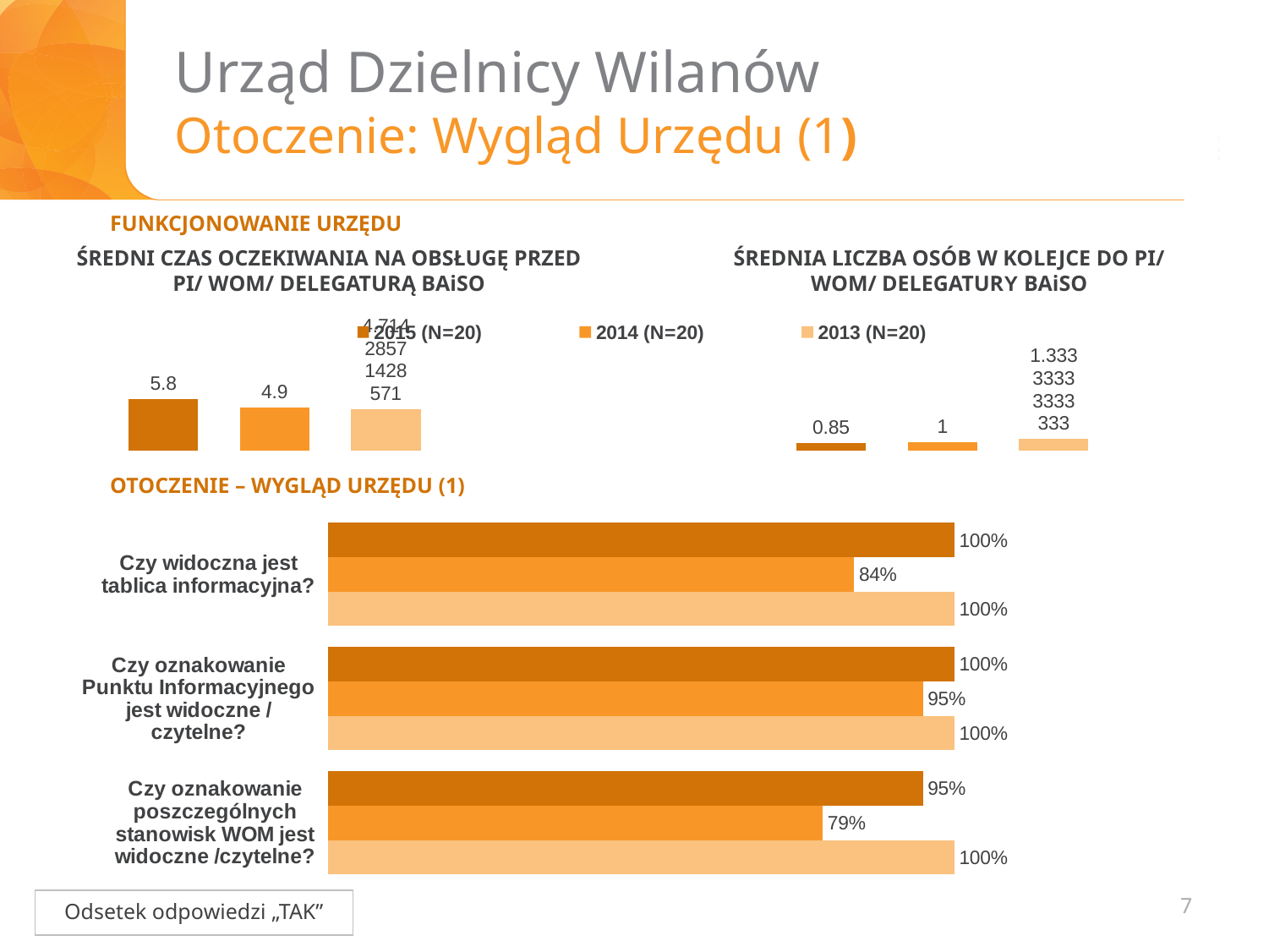
In the bottom chart (Otoczenie – Wygląd Urzędu), which year has the lowest value for "Czy oznakowanie poszczególnych stanowisk WOM jest widoczne /czytelne?"? 2014 In the bottom chart (Otoczenie – Wygląd Urzędu), what is the 2014 value for "Czy oznakowanie Punktu Informacyjnego jest widoczne / czytelne?"? 95% In the chart titled "Średni czas oczekiwania na obsługę przed PI/ WOM/ Delegaturą BAiSO", which is larger, the 2015 value or the 2014 value? 2015 In the bottom chart (Otoczenie – Wygląd Urzędu), what is the 2015 value for "Czy oznakowanie poszczególnych stanowisk WOM jest widoczne /czytelne?"? 95% What kind of chart is the bottom chart (Otoczenie – Wygląd Urzędu)? Bar chart In the bottom chart (Otoczenie – Wygląd Urzędu), how many question categories are shown? 3 In the bottom chart (Otoczenie – Wygląd Urzędu), what is the difference between the 2015 and 2014 values for "Czy widoczna jest tablica informacyjna?"? 16% In the bottom chart (Otoczenie – Wygląd Urzędu), what is the 2014 value for "Czy widoczna jest tablica informacyjna?"? 84% In the bottom chart (Otoczenie – Wygląd Urzędu), what is the difference between the 2013 and 2014 values for "Czy oznakowanie poszczególnych stanowisk WOM jest widoczne /czytelne?"? 21% In the chart titled "Średnia liczba osób w kolejce do PI/ WOM/ Delegatury BAiSO", what is the value for 2015? 0.85 How many series does the legend list for the charts on this slide? 3 In the chart titled "Średni czas oczekiwania na obsługę przed PI/ WOM/ Delegaturą BAiSO", what is the value for 2015? 5.8